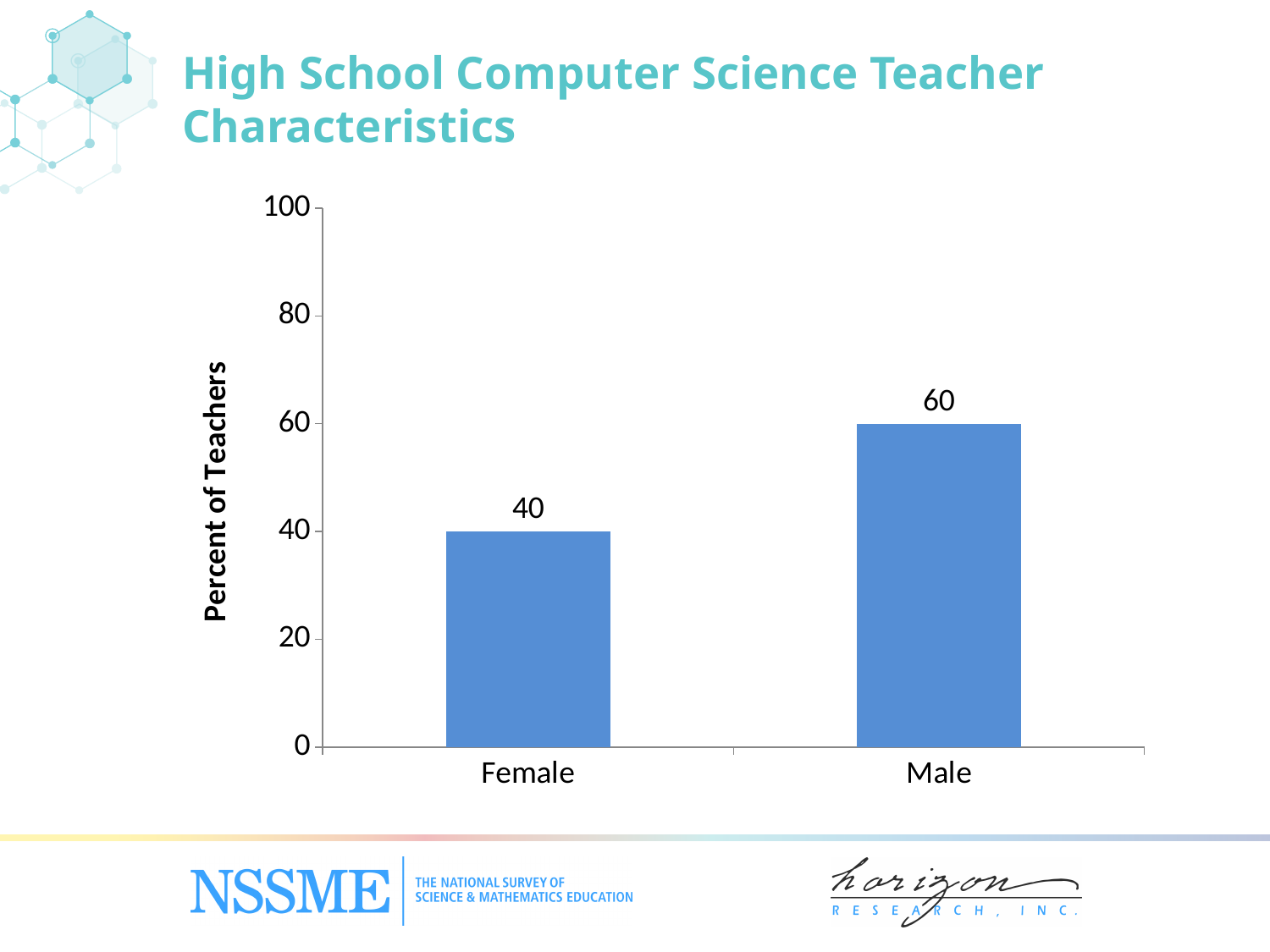
What is the difference between the values for Male and Female? 20 How many categories are shown on the x axis? 2 What kind of chart is shown on the slide? bar chart What is the value for Male? 60 Is the value for Male greater or less than 40? greater What is the label of the y axis? Percent of Teachers What is the title of the slide? High School Computer Science Teacher Characteristics What is the value for Female? 40 Is the value for Female greater or less than 60? less Which category has the lowest value? Female Which is larger, the value for Female or the value for Male? Male Which category has the highest value? Male